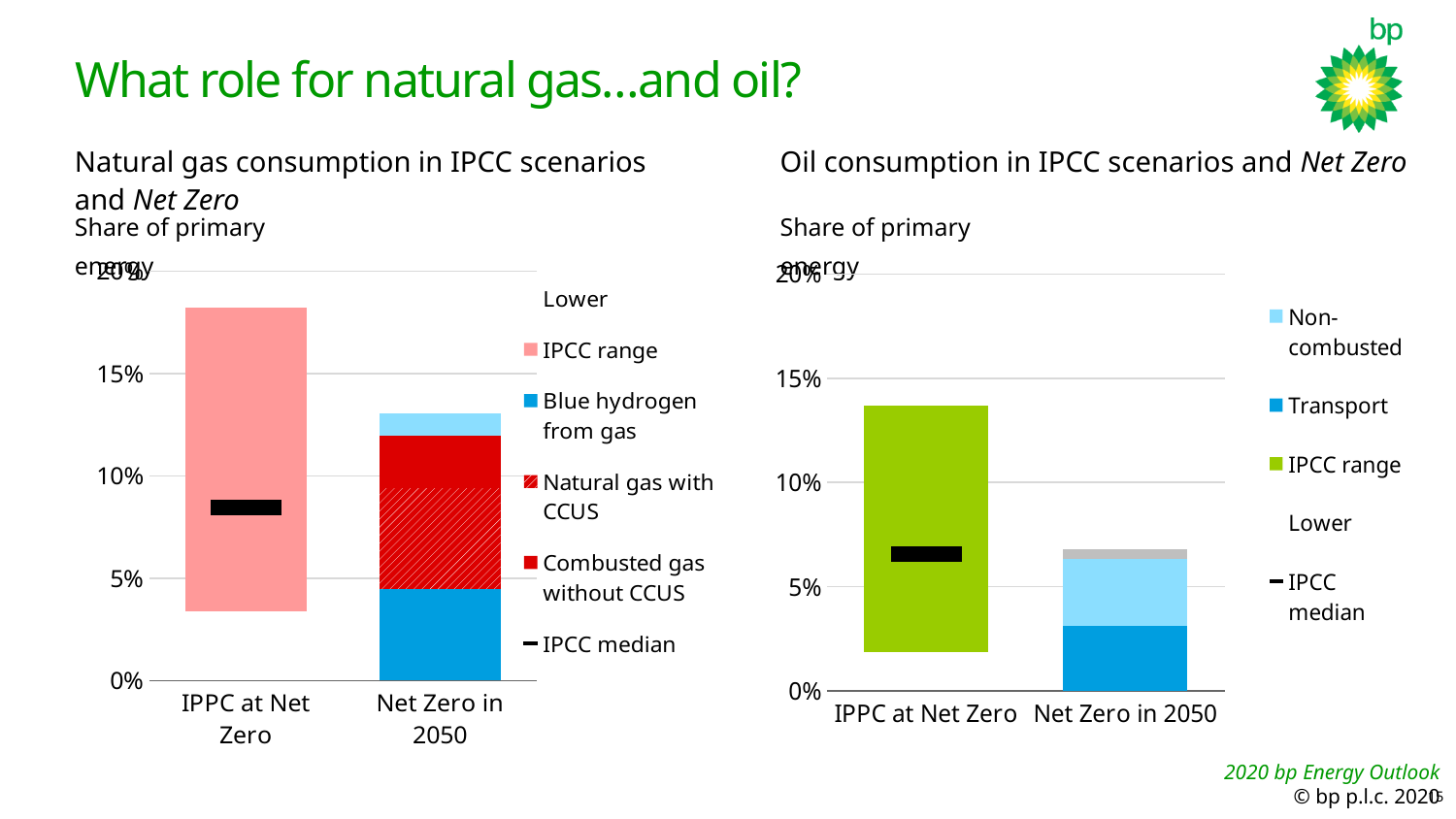
In the 'Oil consumption in IPCC scenarios and Net Zero' chart, what colour is the 'IPCC range' bar? green What kind of chart is the 'Natural gas consumption in IPCC scenarios and Net Zero' chart? bar chart In the 'Natural gas consumption in IPCC scenarios and Net Zero' chart, is the IPCC median for 'IPPC at Net Zero' greater or less than 10%? less In the 'Oil consumption in IPCC scenarios and Net Zero' chart, is the top of the IPCC range bar for 'IPPC at Net Zero' greater or less than 15%? less In the 'Natural gas consumption in IPCC scenarios and Net Zero' chart, which bar reaches higher: 'IPPC at Net Zero' or 'Net Zero in 2050'? IPPC at Net Zero How many categories are shown on the x axis of the 'Oil consumption in IPCC scenarios and Net Zero' chart? 2 In the 'Natural gas consumption in IPCC scenarios and Net Zero' chart, is the 'Blue hydrogen from gas' segment for 'Net Zero in 2050' greater or less than 5%? less In the 'Oil consumption in IPCC scenarios and Net Zero' chart, which bar reaches higher: 'IPPC at Net Zero' or 'Net Zero in 2050'? IPPC at Net Zero